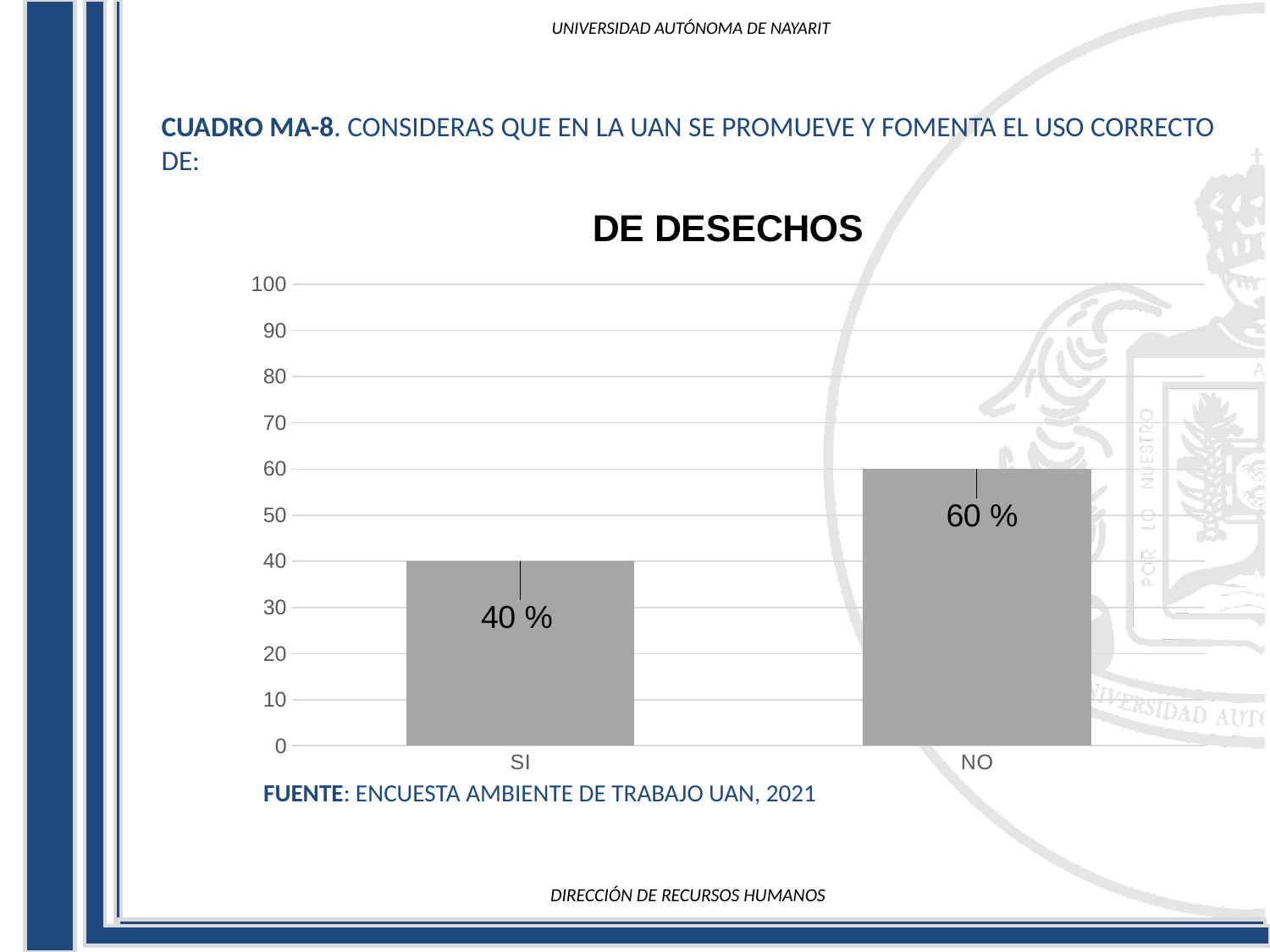
What is the value for NO? 60 % Which is larger, the value for SI or the value for NO? NO What is the difference between the values for NO and SI? 20 % What kind of chart is shown on the slide? bar chart Which category has the lowest value? SI Which category has the highest value? NO What is the highest value shown on the vertical axis? 100 What is the value for SI? 40 % How many categories are shown on the x axis? 2 Is the value for SI greater or less than 50? less What is the title of the chart? DE DESECHOS Is the value for NO greater or less than 50? greater